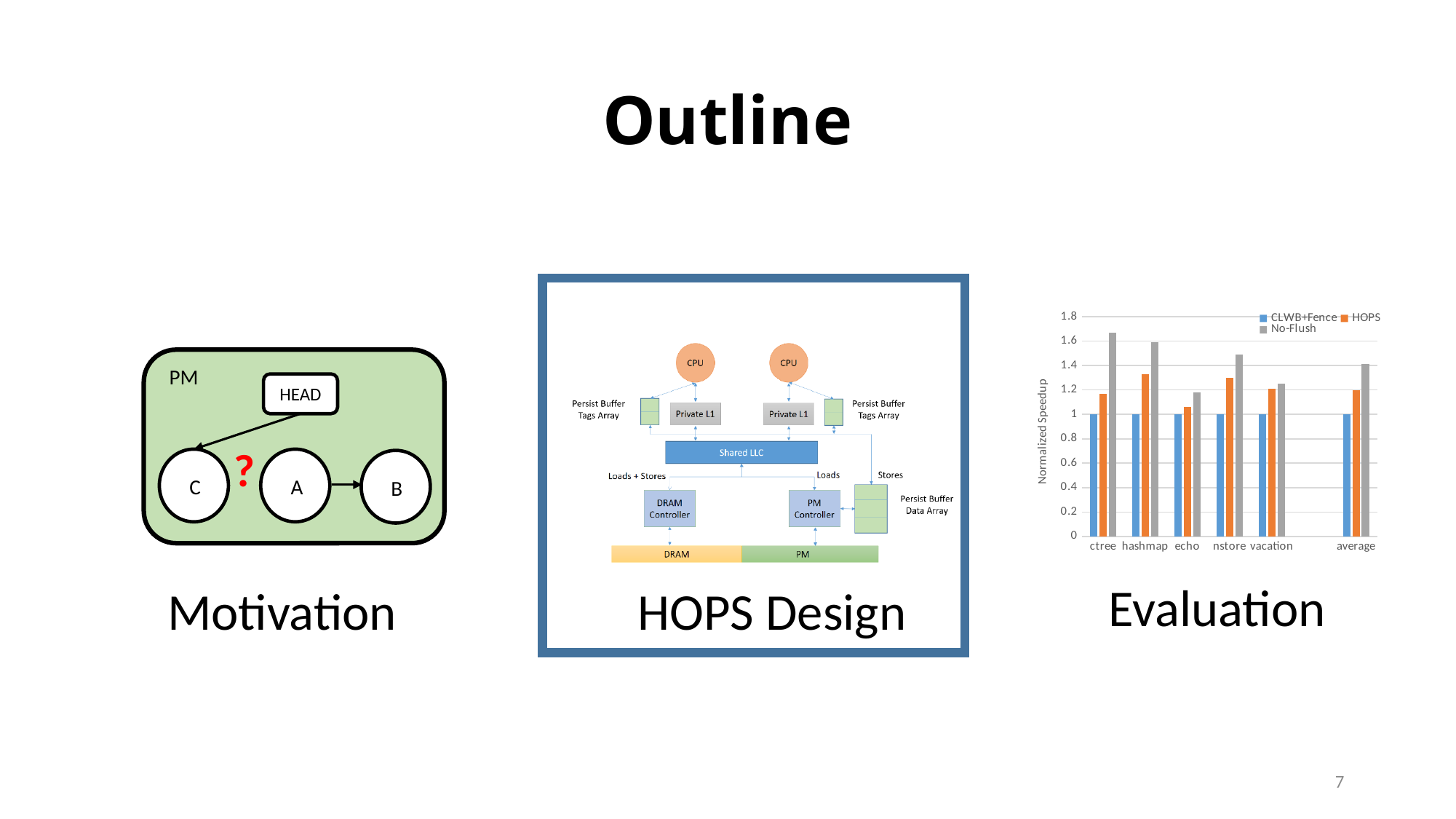
What is the y-axis title of the Evaluation chart? Normalized Speedup In the Evaluation chart, is the No-Flush value for ctree greater or less than 1.6? greater How many series does the legend of the Evaluation chart list? 3 In the Evaluation chart, is the No-Flush value for average greater or less than 1.2? greater Which series in the Evaluation chart is drawn in orange? HOPS In the Evaluation chart, which category has the lowest HOPS value? echo In the Evaluation chart, is the HOPS value for hashmap greater or less than 1.2? greater In the Evaluation chart, what is the CLWB+Fence value for ctree? 1 What kind of chart is shown under the Evaluation heading? bar chart How many categories are shown on the x axis of the Evaluation chart? 6 In the Evaluation chart, for ctree, which is larger: the HOPS value or the No-Flush value? No-Flush